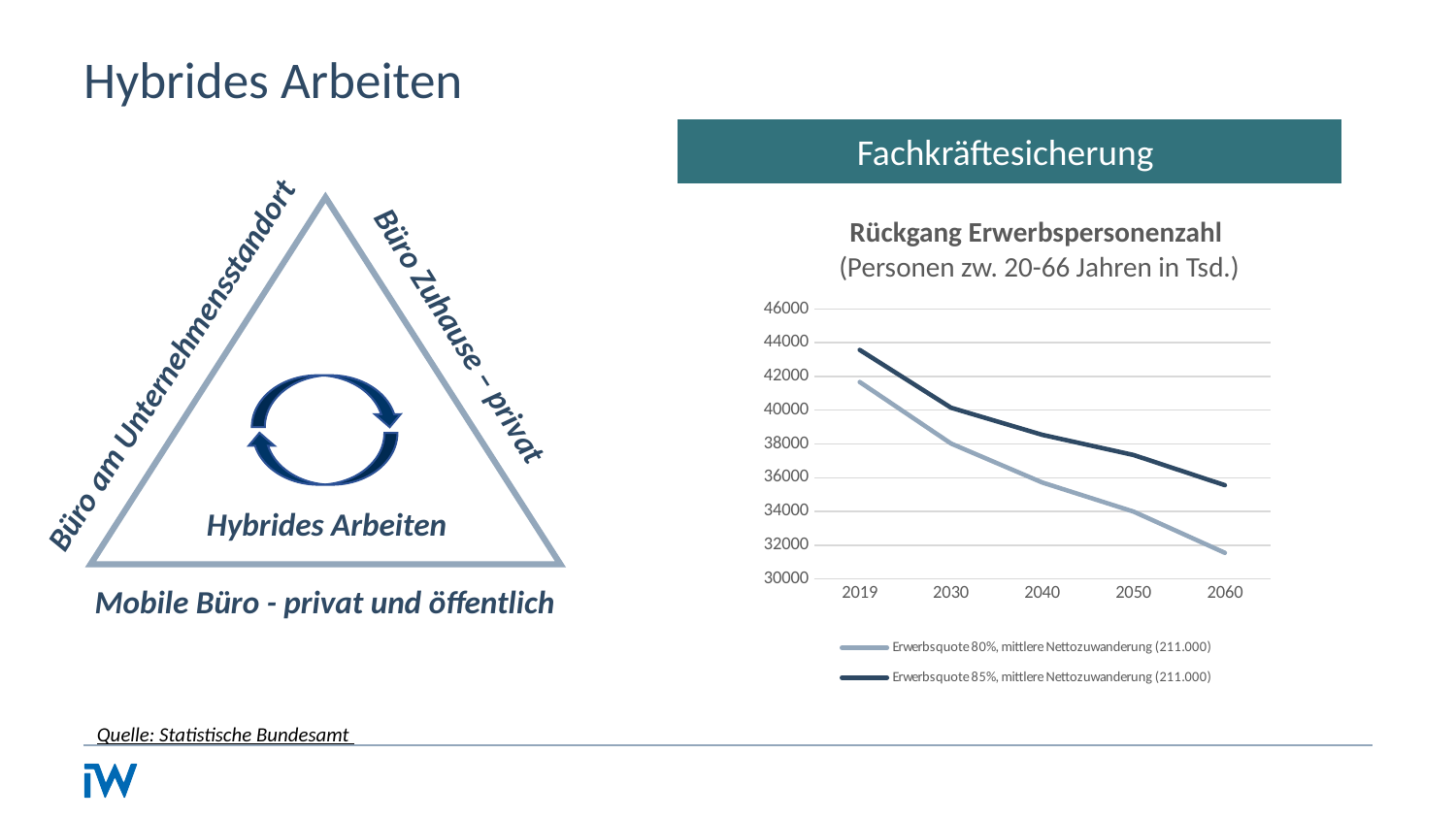
In 2060, which series is higher: Erwerbsquote 80% or Erwerbsquote 85%? Erwerbsquote 85%, mittlere Nettozuwanderung (211.000) Is the 2019 value for the Erwerbsquote 80% series greater or less than 40000? greater Which year has the lowest value for the Erwerbsquote 85% series? 2060 What is the title of the chart on the right side of the slide? Rückgang Erwerbspersonenzahl What kind of chart is shown under the heading Fachkräftesicherung? line chart How many years are shown on the x axis of the Rückgang Erwerbspersonenzahl chart? 5 Is the 2060 value for the Erwerbsquote 85% series greater or less than 34000? greater Is the 2060 value for the Erwerbsquote 80% series greater or less than 32000? less How many series does the legend of the Rückgang Erwerbspersonenzahl chart list? 2 Do the values in the Rückgang Erwerbspersonenzahl chart rise or fall from 2019 to 2060? fall